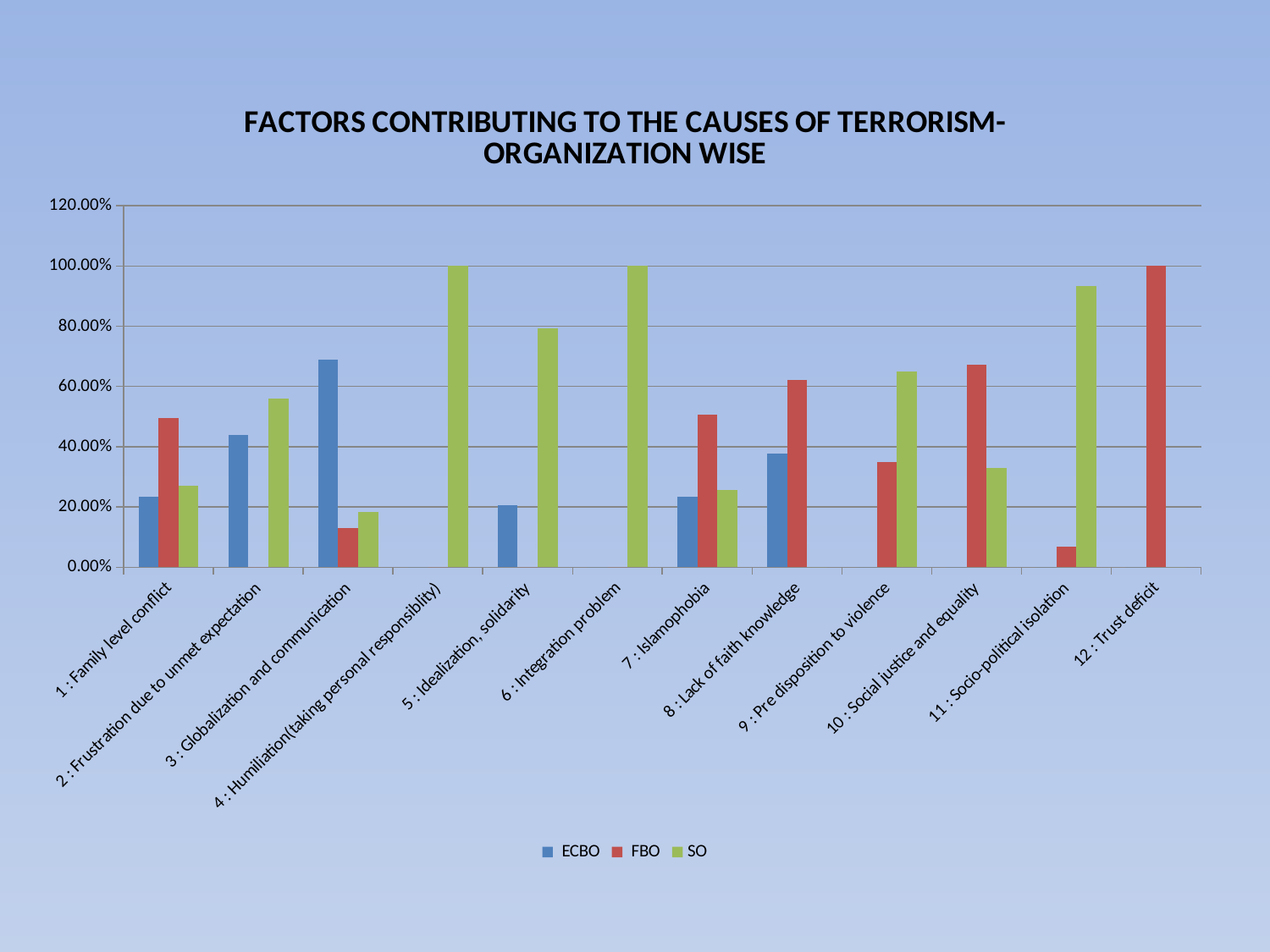
What kind of chart is shown on the slide? bar chart Is the SO value for "9 : Pre disposition to violence" greater or less than 60.00%? greater Which has the larger SO value, "2 : Frustration due to unmet expectation" or "3 : Globalization and communication"? 2 : Frustration due to unmet expectation Which series has the highest value for "5 : Idealization, solidarity"? SO For "1 : Family level conflict", which is larger, the ECBO value or the FBO value? FBO How many categories are shown on the x axis? 12 What is the FBO value for "12 : Trust deficit"? 100.00% What are the three series names listed in the legend? ECBO, FBO, SO How many series does the legend list? 3 What is the SO value for "4 : Humiliation(taking personal responsiblity)"? 100.00% Is the ECBO value for "3 : Globalization and communication" greater or less than 60.00%? greater Is the FBO value for "11 : Socio-political isolation" greater or less than 20.00%? less